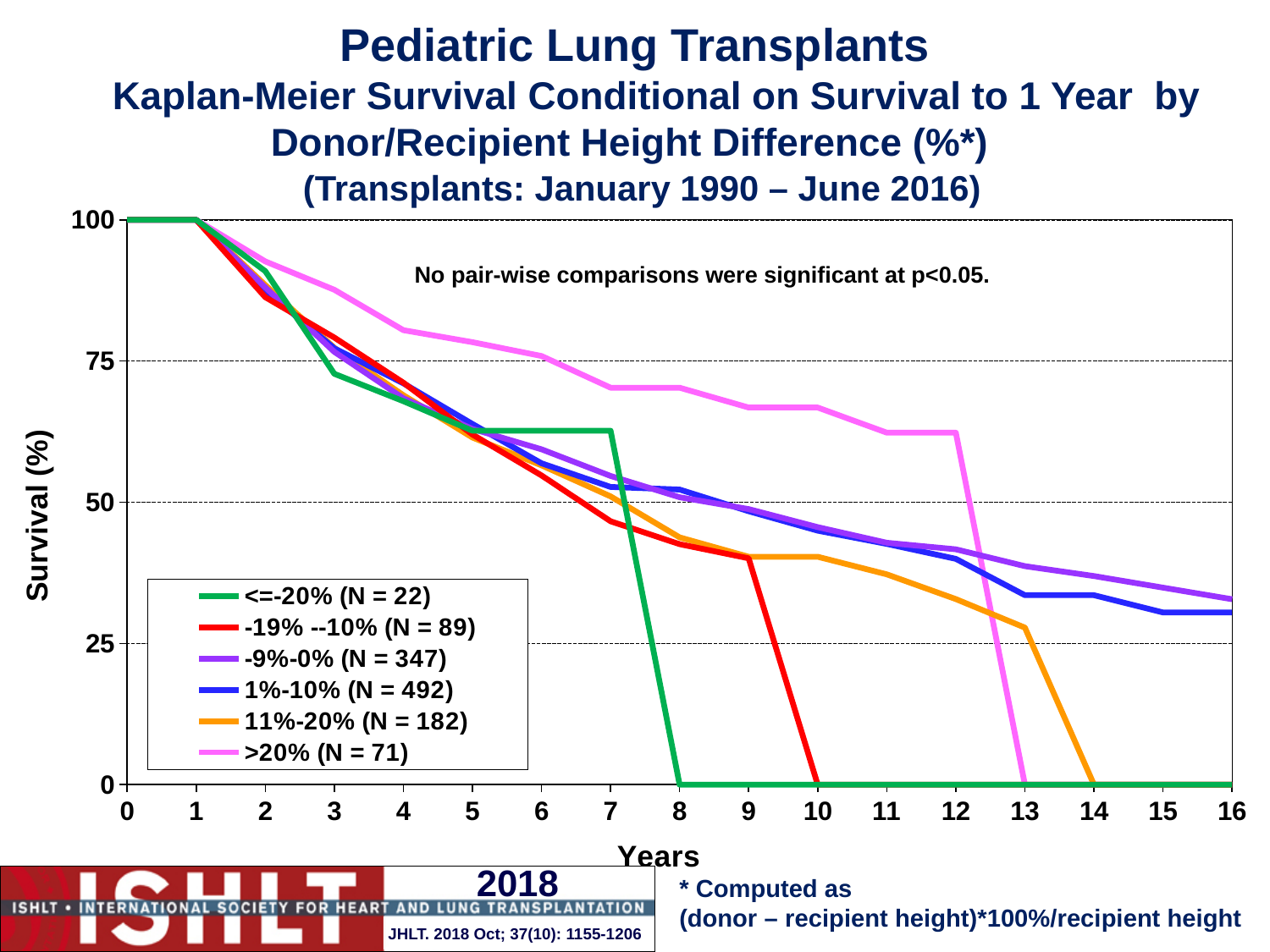
Which group is the first to drop to 0% survival? <=-20% (N = 22) According to the legend, what is the N for the 1%-10% group? 492 What is the survival (%) for all groups at year 1? 100 What is the survival (%) for the <=-20% group at year 8? 0 What kind of chart is shown on the slide? line chart Is the survival value for the >20% group at year 12 greater or less than 50? greater Is the survival value for the 1%-10% group at year 16 greater or less than 25? greater At year 12, which group has the highest survival? >20% (N = 71) At year 7, which is higher: the survival of the <=-20% group or the -19% - -10% group? <=-20% group How many series does the legend list? 6 Do the survival curves rise or fall as years increase? fall Is the survival value for the >20% group at year 3 greater or less than 75? greater